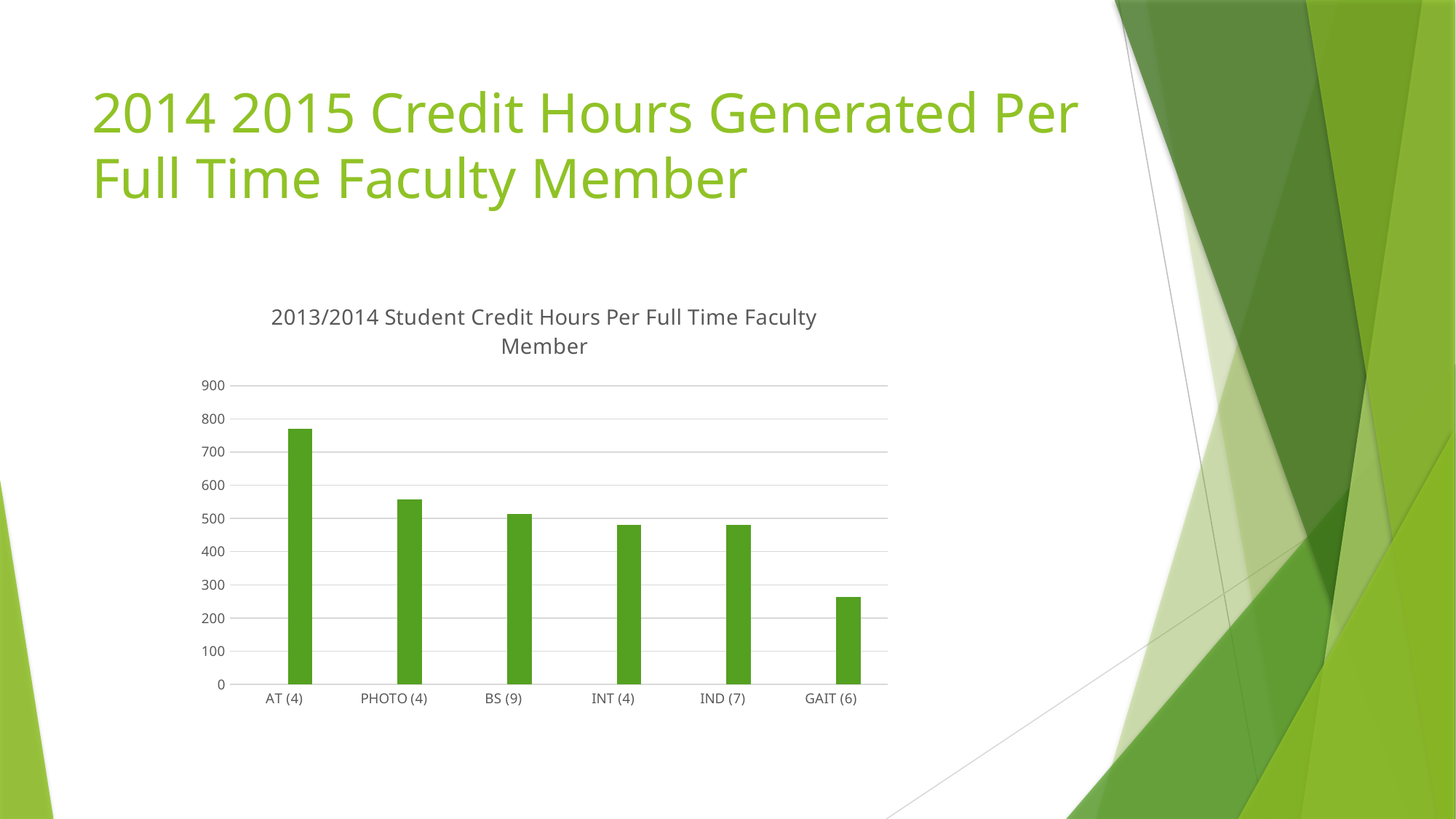
Do the values generally rise or fall from left to right along the x axis? fall Which is larger, the value for AT (4) or the value for PHOTO (4)? AT (4) Is the value for PHOTO (4) greater or less than 500? greater How many categories are plotted on the x axis? 6 Is the value for INT (4) greater or less than 500? less What kind of chart is shown on the slide? bar chart Is the value for AT (4) greater or less than 700? greater Which category has the highest value? AT (4) What is the title of the chart? 2013/2014 Student Credit Hours Per Full Time Faculty Member Which category has the lowest value? GAIT (6) Which is larger, the value for IND (7) or the value for GAIT (6)? IND (7)